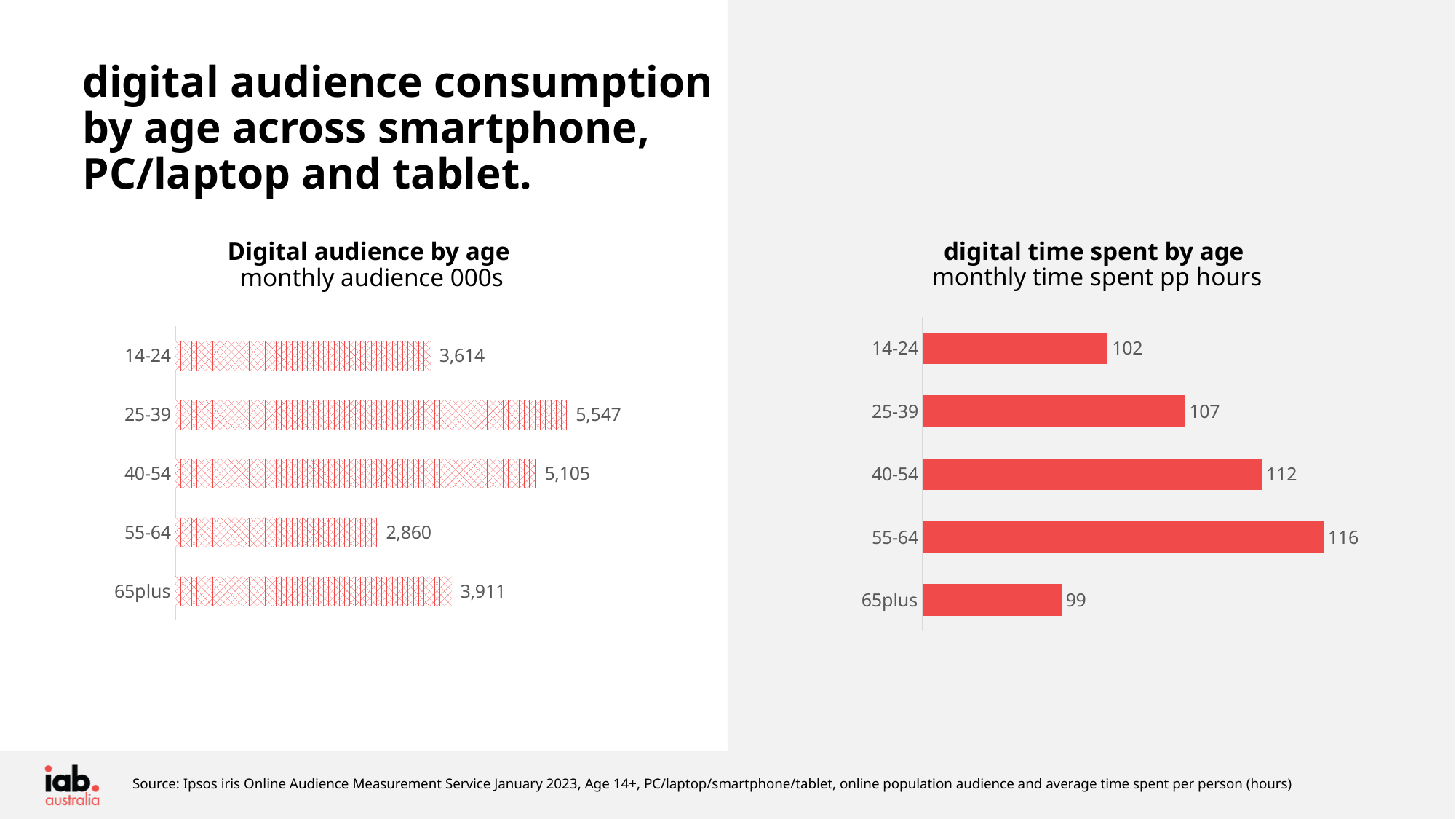
In the 'Digital audience by age' chart, which age group has the lowest monthly audience? 55-64 In the 'digital time spent by age' chart, what is the monthly time spent for the 40-54 age group? 112 In the 'digital time spent by age' chart, which age group has the lowest monthly time spent? 65plus In the 'digital time spent by age' chart, what is the difference between the 55-64 and 14-24 values? 14 In the 'digital time spent by age' chart, which age group has the highest monthly time spent? 55-64 In the 'digital time spent by age' chart, which is larger: the value for 25-39 or the value for 65plus? 25-39 In the 'Digital audience by age' chart, which age group has the highest monthly audience? 25-39 In the 'Digital audience by age' chart, how many age groups are shown? 5 In the 'Digital audience by age' chart, what is the difference between the 25-39 and 40-54 values? 442 What kind of chart is the 'digital time spent by age' chart? Bar chart In the 'Digital audience by age' chart, what is the value for the 65plus age group? 3,911 In the 'Digital audience by age' chart, what is the monthly audience (000s) for the 25-39 age group? 5,547